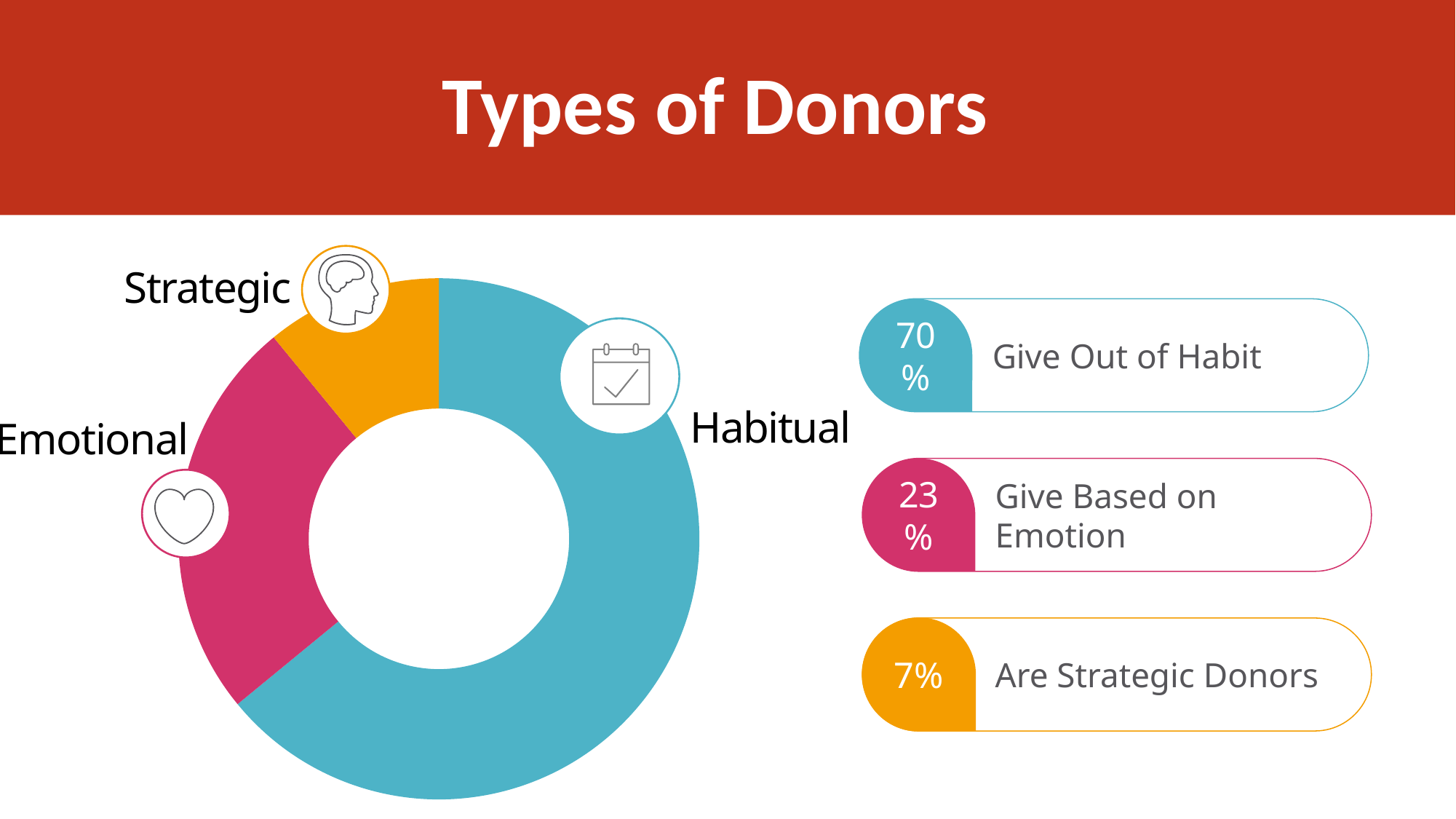
What is the title of the slide? Types of Donors What is the difference in percentage points between Habitual and Emotional donors? 47 What percentage of donors are Strategic donors? 7% What is the difference in percentage points between Emotional and Strategic donors? 16 How many donor types are shown in the chart? 3 What percentage of donors give based on emotion? 23% Which type of donor has the smallest share of the chart? Strategic What kind of chart is shown on the slide? Doughnut chart Which type of donor has the largest share of the chart? Habitual What percentage of donors are Habitual donors? 70% What colour represents the Emotional donors in the chart? Pink Which is larger, the share of Emotional donors or the share of Strategic donors? Emotional